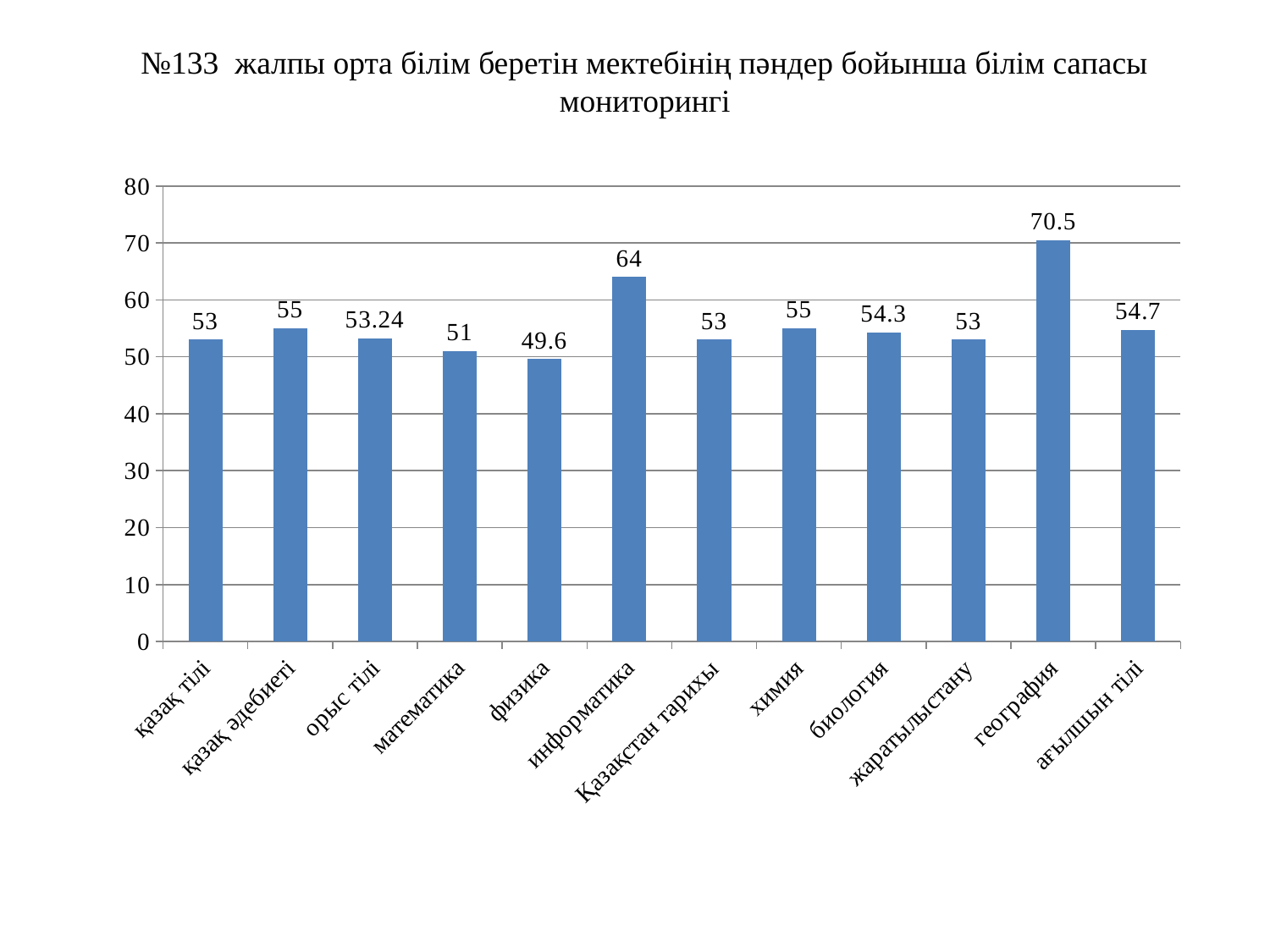
Which is larger, the value for информатика or the value for химия? информатика What kind of chart is shown on the slide? bar chart What is the difference between the values for биология and математика? 3.3 Which category has the highest value? география Is the value for география greater or less than 60? greater What is the value for физика? 49.6 How many categories are shown on the x axis? 12 What is the difference between the values for география and информатика? 6.5 What is the value for география? 70.5 What is the value for орыс тілі? 53.24 Which category has the lowest value? физика What is the value for ағылшын тілі? 54.7